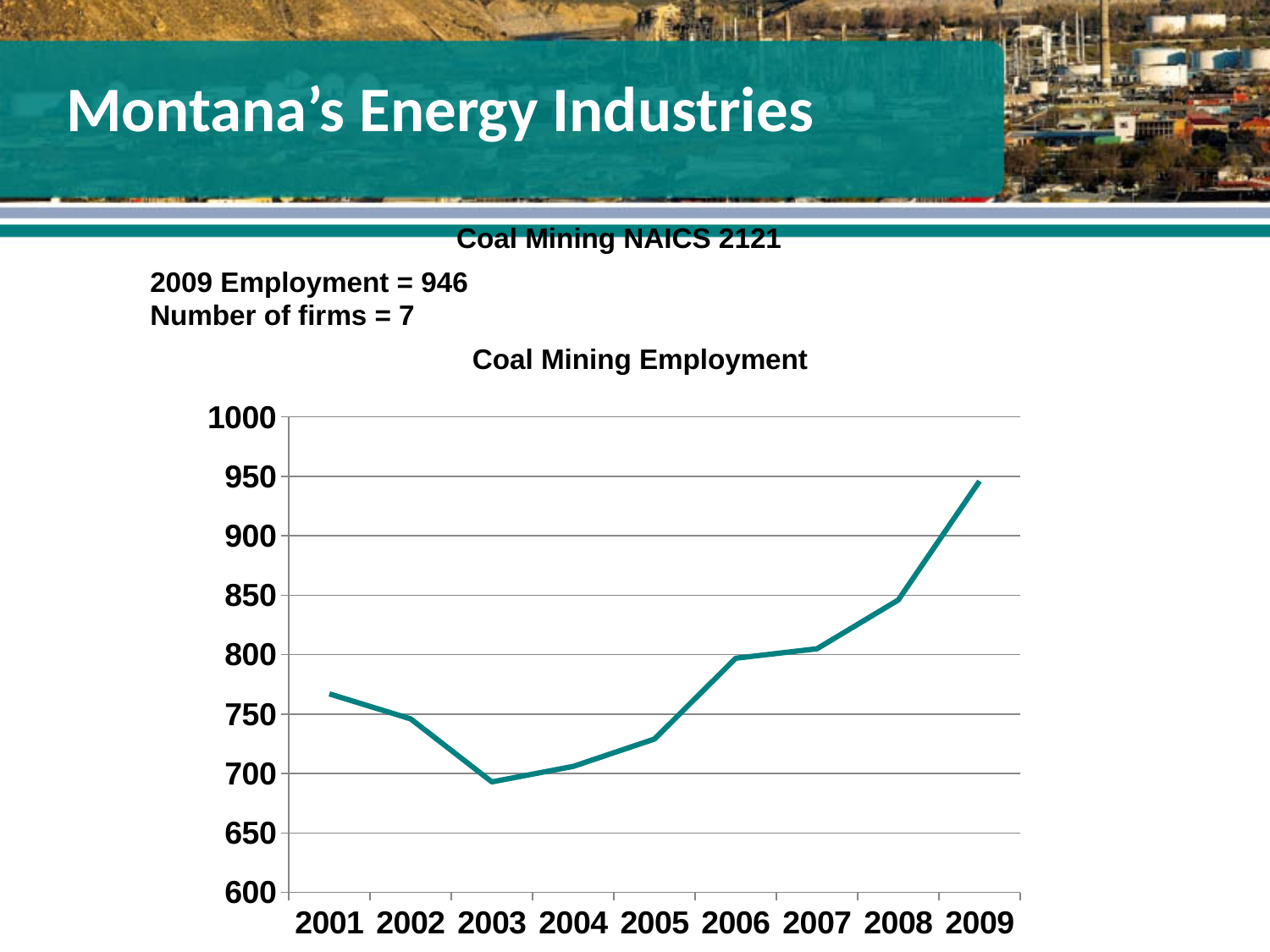
Is the value for 2005 greater or less than 750? less Which year has the lowest coal mining employment in the chart? 2003 Which year has the highest coal mining employment in the chart? 2009 What kind of chart is shown on the slide? line chart What is the coal mining employment value for 2009? 946 Which year has the larger value, 2005 or 2006? 2006 What is the title of the chart? Coal Mining Employment Which year has the larger value, 2001 or 2003? 2001 Does coal mining employment rise or fall from 2003 to 2009? rise How many years are plotted on the x axis of the chart? 9 Is the value for 2009 greater or less than 900? greater Is the value for 2001 greater or less than 750? greater